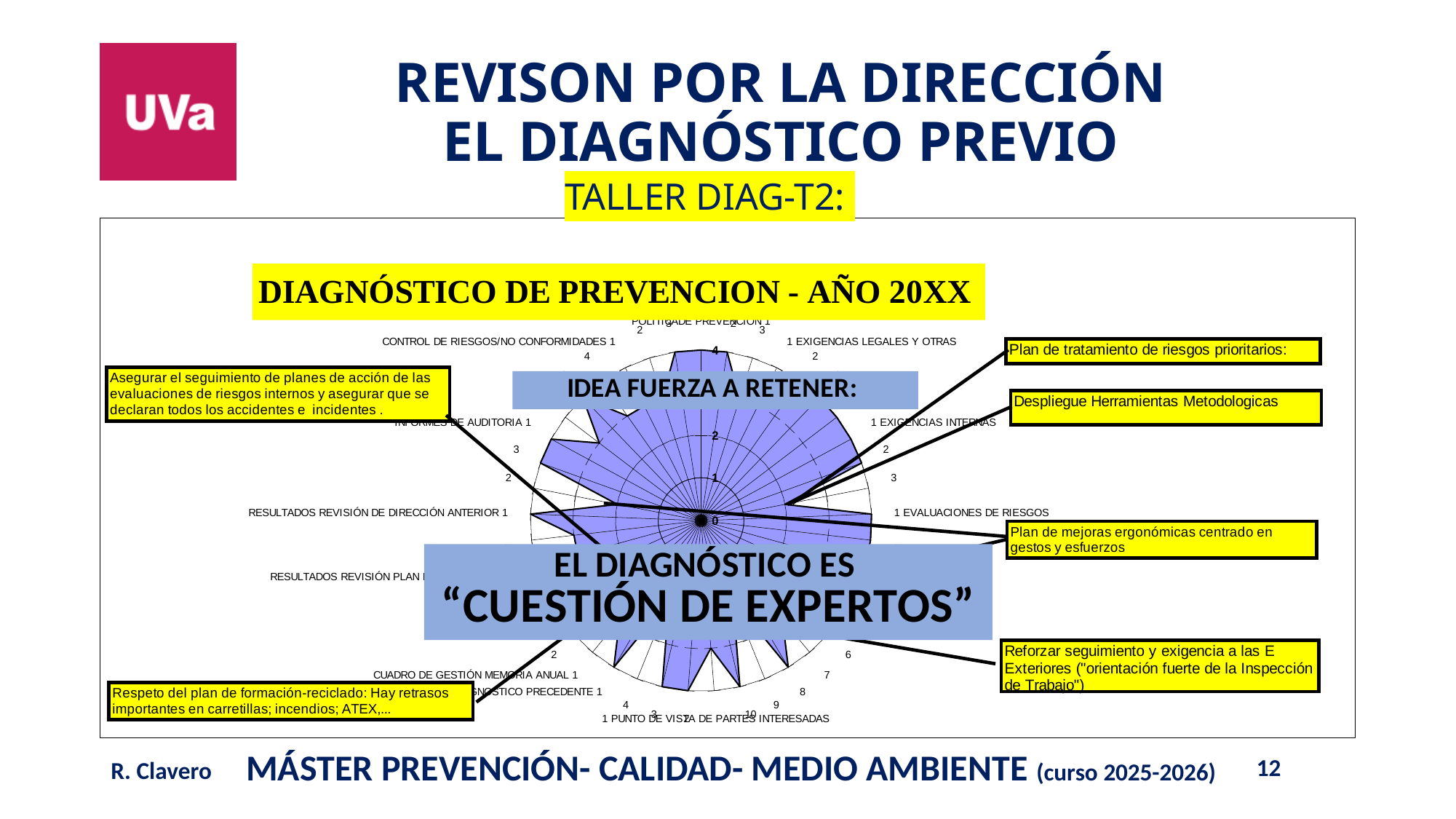
What is the title of the chart? DIAGNÓSTICO DE PREVENCION - AÑO 20XX Is the value for POLITICA DE PREVENCION 1 greater or less than 2? greater What is the highest tick value shown on the chart's radial axis? 4 What kind of chart is shown on the slide? radar chart